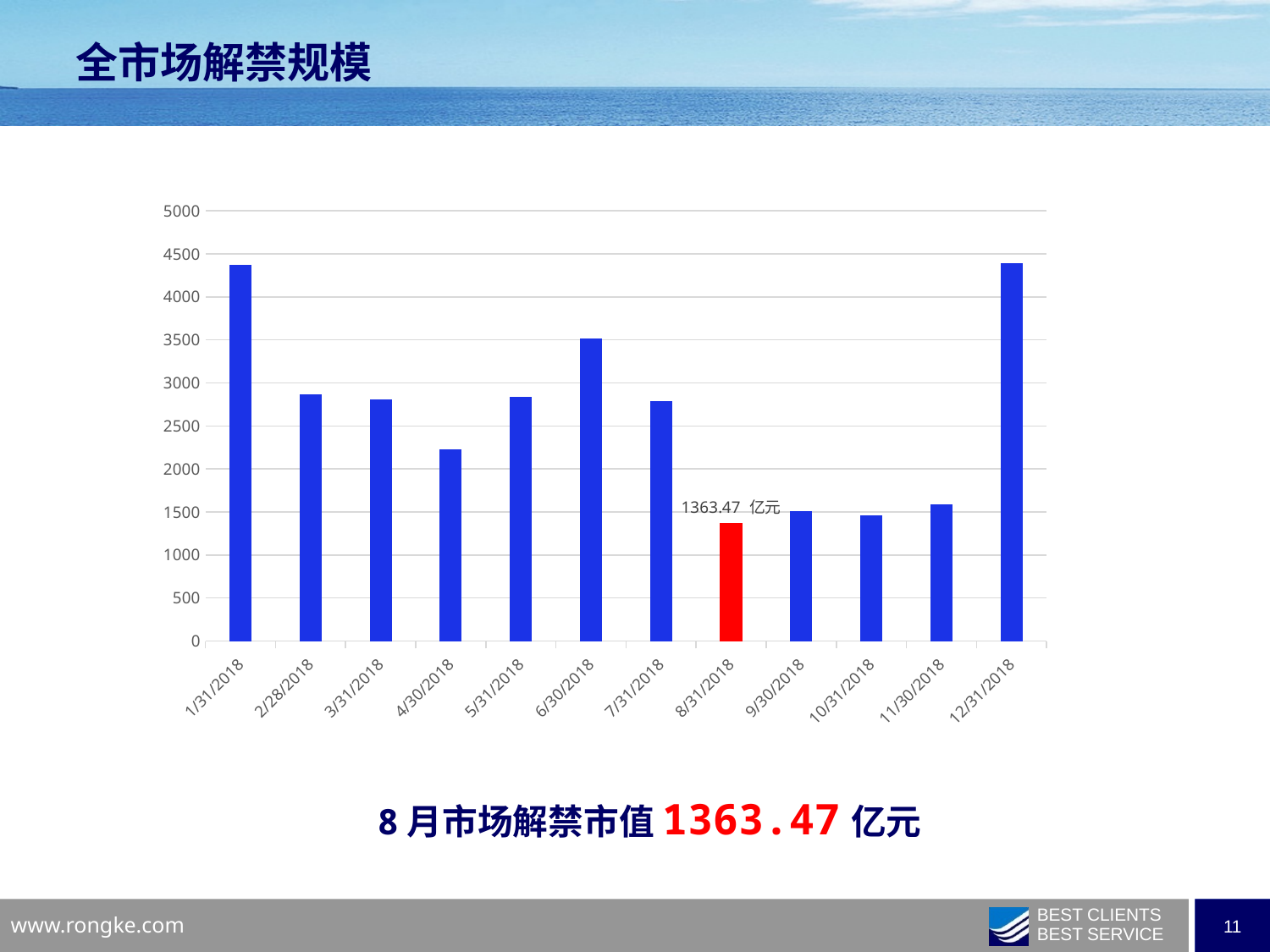
Is the value for 11/30/2018 greater or less than 2000? less Which bar in the chart is coloured red? 8/31/2018 Which is larger, the value for 6/30/2018 or the value for 7/31/2018? 6/30/2018 What kind of chart is shown on the slide? bar chart Which is larger, the value for 4/30/2018 or the value for 5/31/2018? 5/31/2018 What is the title of the slide containing the chart? 全市场解禁规模 Is the value for 7/31/2018 greater or less than 2500? greater How many dates are shown on the x axis of the chart? 12 Is the value for 1/31/2018 greater or less than 4000? greater What is the value for 8/31/2018? 1363.47 亿元